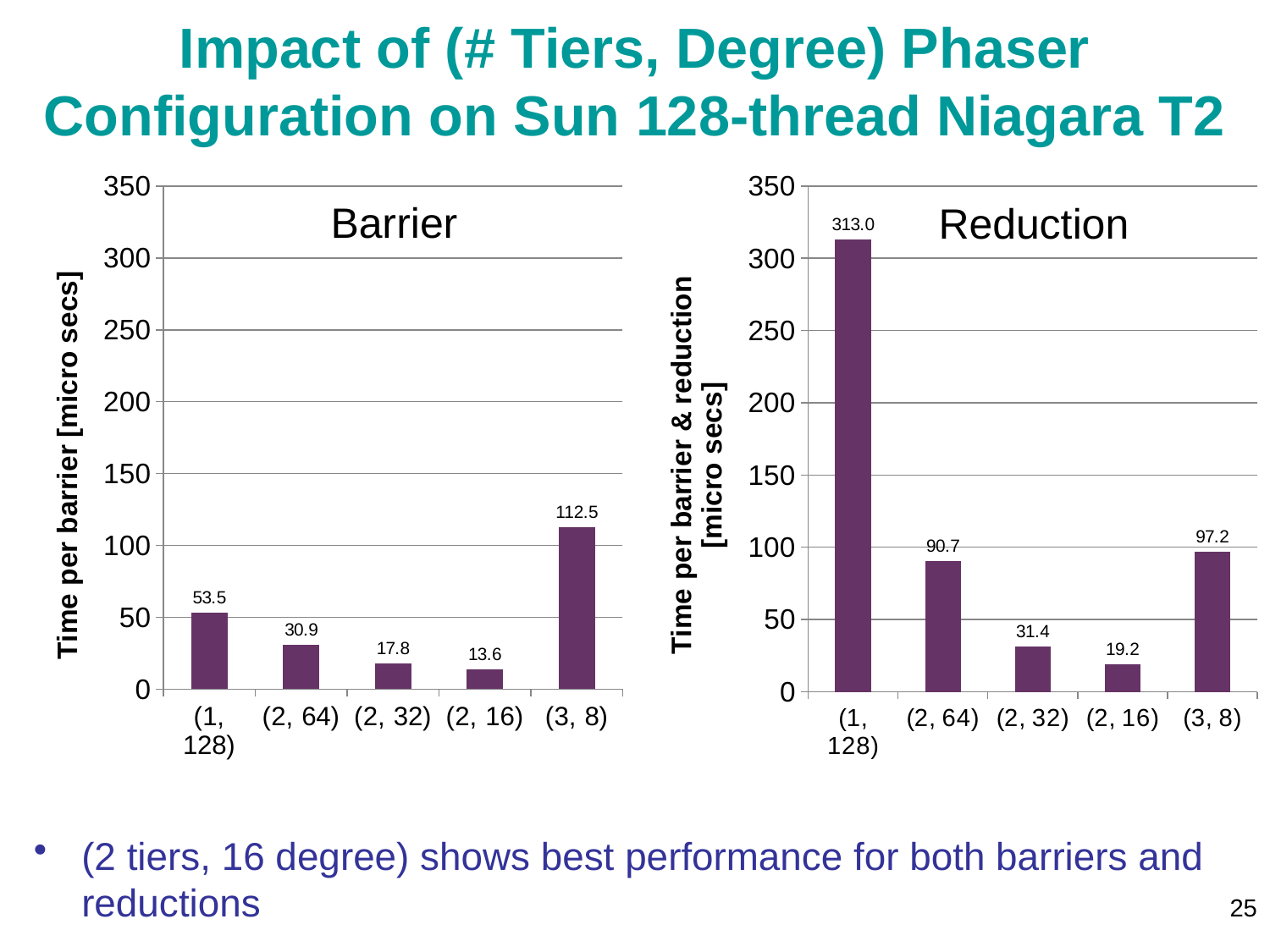
What is the y-axis label of the Reduction chart? Time per barrier & reduction [micro secs] How many configurations are shown on the x axis of the Reduction chart? 5 In the Reduction chart, which is larger, the value for (2, 64) or the value for (3, 8)? (3, 8) In the Barrier chart, what is the time per barrier for the (2, 64) configuration? 30.9 In the Reduction chart, what is the value for the (1, 128) configuration? 313.0 In the Barrier chart, which configuration has the lowest time per barrier? (2, 16) In the Reduction chart, which configuration has the highest value? (1, 128) In the Reduction chart, what is the difference between the values for (2, 64) and (2, 16)? 71.5 In the Barrier chart, which configuration has the highest time per barrier? (3, 8) In the Barrier chart, is the value for (3, 8) greater or less than 100? greater In the Barrier chart, what is the difference between the values for (3, 8) and (1, 128)? 59.0 What kind of chart is the Barrier chart? bar chart